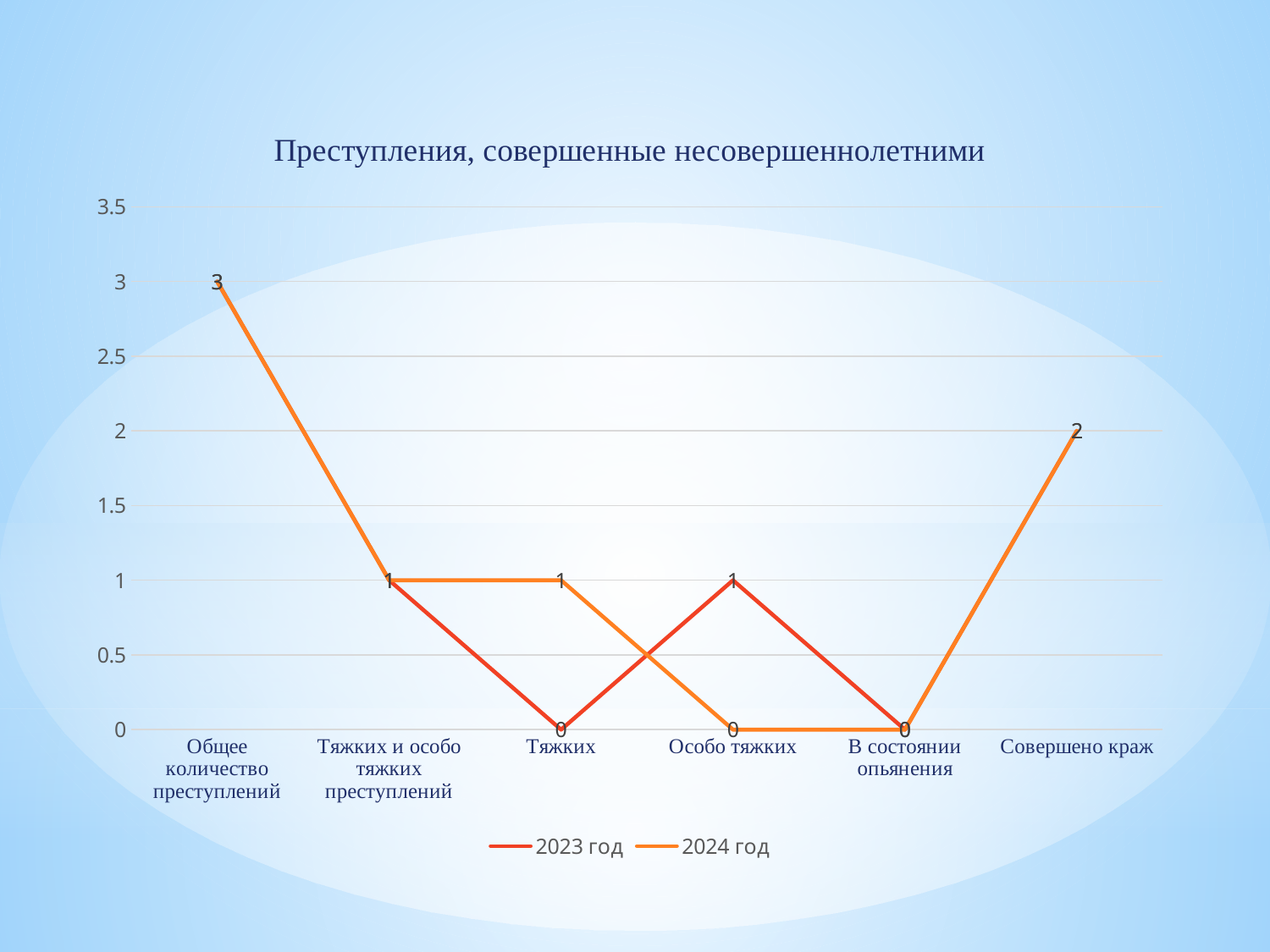
What is the difference between Общее количество преступлений and Совершено краж for 2024 год? 1 How many series does the legend list? 2 What is the value for Особо тяжких in 2023 год? 1 How many categories are shown on the x axis? 6 What is the title of the chart? Преступления, совершенные несовершеннолетними Which category has the highest value for 2023 год? Общее количество преступлений What is the value for Общее количество преступлений in 2023 год? 3 Which series is drawn in red? 2023 год Which is larger for Тяжких: the 2023 год value or the 2024 год value? 2024 год What is the value for Совершено краж in 2024 год? 2 What kind of chart is shown on the slide? line chart What is the value for Тяжких in 2024 год? 1